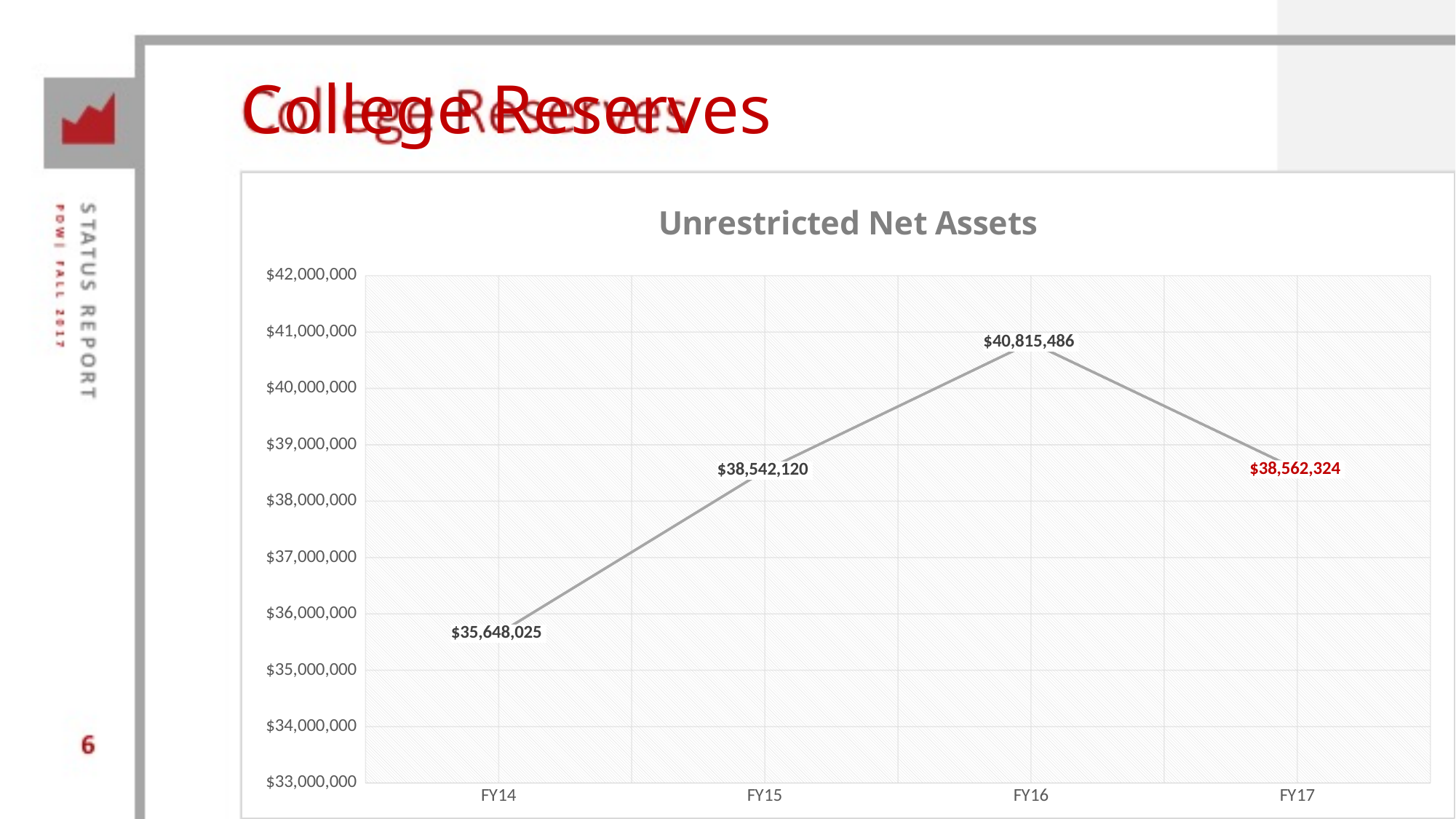
What is the difference in Unrestricted Net Assets between FY16 and FY17? $2,253,162 Is the value for FY14 greater or less than $36,000,000? less How many fiscal years are plotted on the chart? 4 What is the value of Unrestricted Net Assets for FY17? $38,562,324 Which fiscal year has the lowest Unrestricted Net Assets? FY14 Which fiscal year has the highest Unrestricted Net Assets? FY16 Which is larger, the Unrestricted Net Assets for FY15 or FY16? FY16 What type of chart is shown on the slide? Line chart What is the difference in Unrestricted Net Assets between FY16 and FY14? $5,167,461 What is the value of Unrestricted Net Assets for FY14? $35,648,025 What is the title of the chart? Unrestricted Net Assets What is the value of Unrestricted Net Assets for FY16? $40,815,486